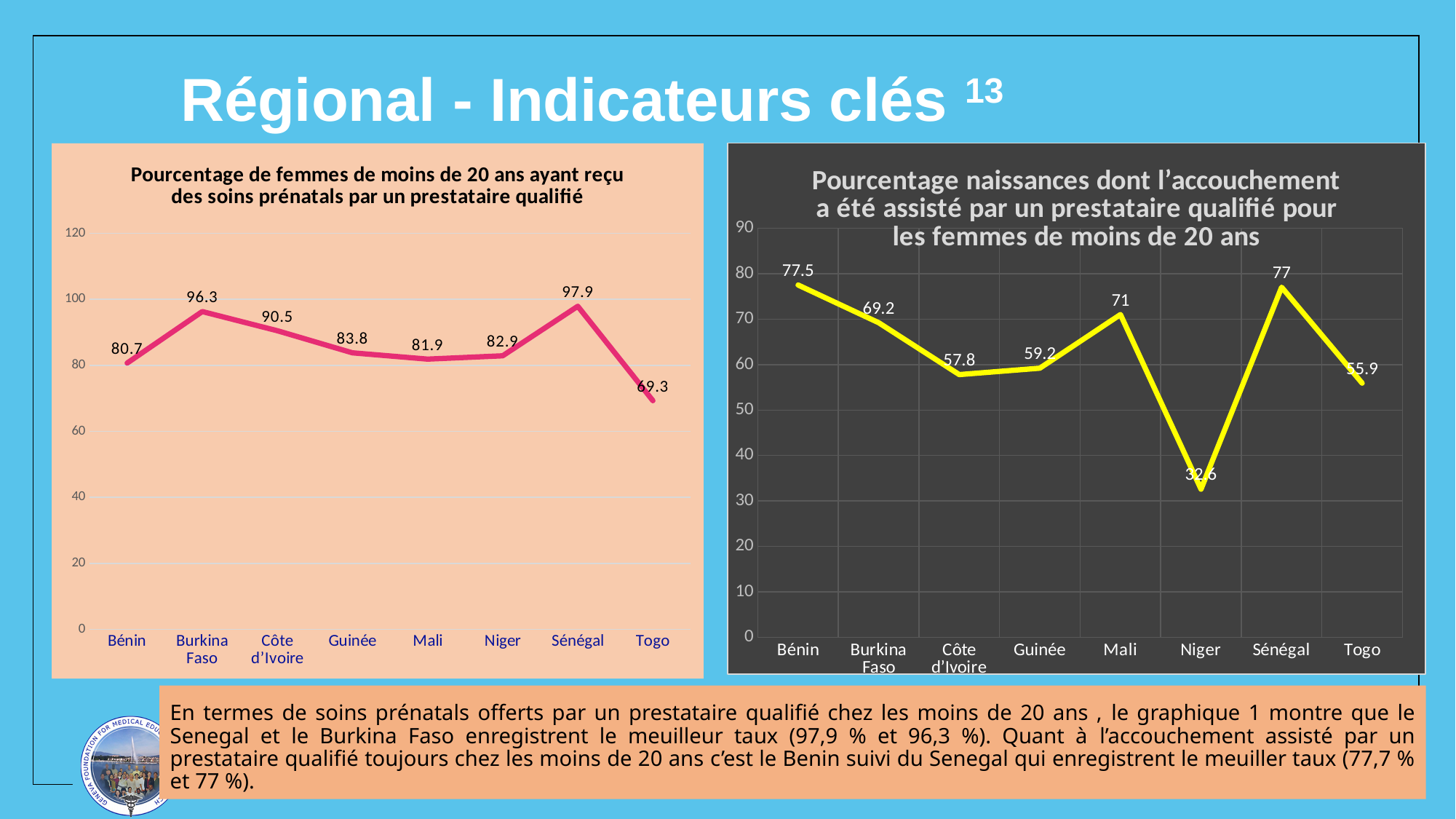
In the right chart (accouchement assisté), which country has the highest value? Bénin In the right chart (accouchement assisté), which country has the lowest value? Niger In the left chart (Pourcentage de femmes de moins de 20 ans ayant reçu des soins prénatals par un prestataire qualifié), what is the value for Sénégal? 97.9 In the left chart (soins prénatals), which country has the lowest value? Togo In the right chart (Pourcentage naissances dont l'accouchement a été assisté par un prestataire qualifié), what is the value for Mali? 71 In the left chart (soins prénatals), how many countries are plotted? 8 In the right chart (accouchement assisté), what is the difference between the values for Bénin and Sénégal? 0.5 In the right chart (accouchement assisté), which is larger, the value for Guinée or the value for Côte d'Ivoire? Guinée In the left chart (soins prénatals), is the value for Côte d'Ivoire greater or less than 80? greater What type of chart is the right chart (accouchement assisté)? Line chart In the left chart (soins prénatals), what is the difference between the values for Burkina Faso and Bénin? 15.6 In the left chart (soins prénatals), which country has the highest value? Sénégal